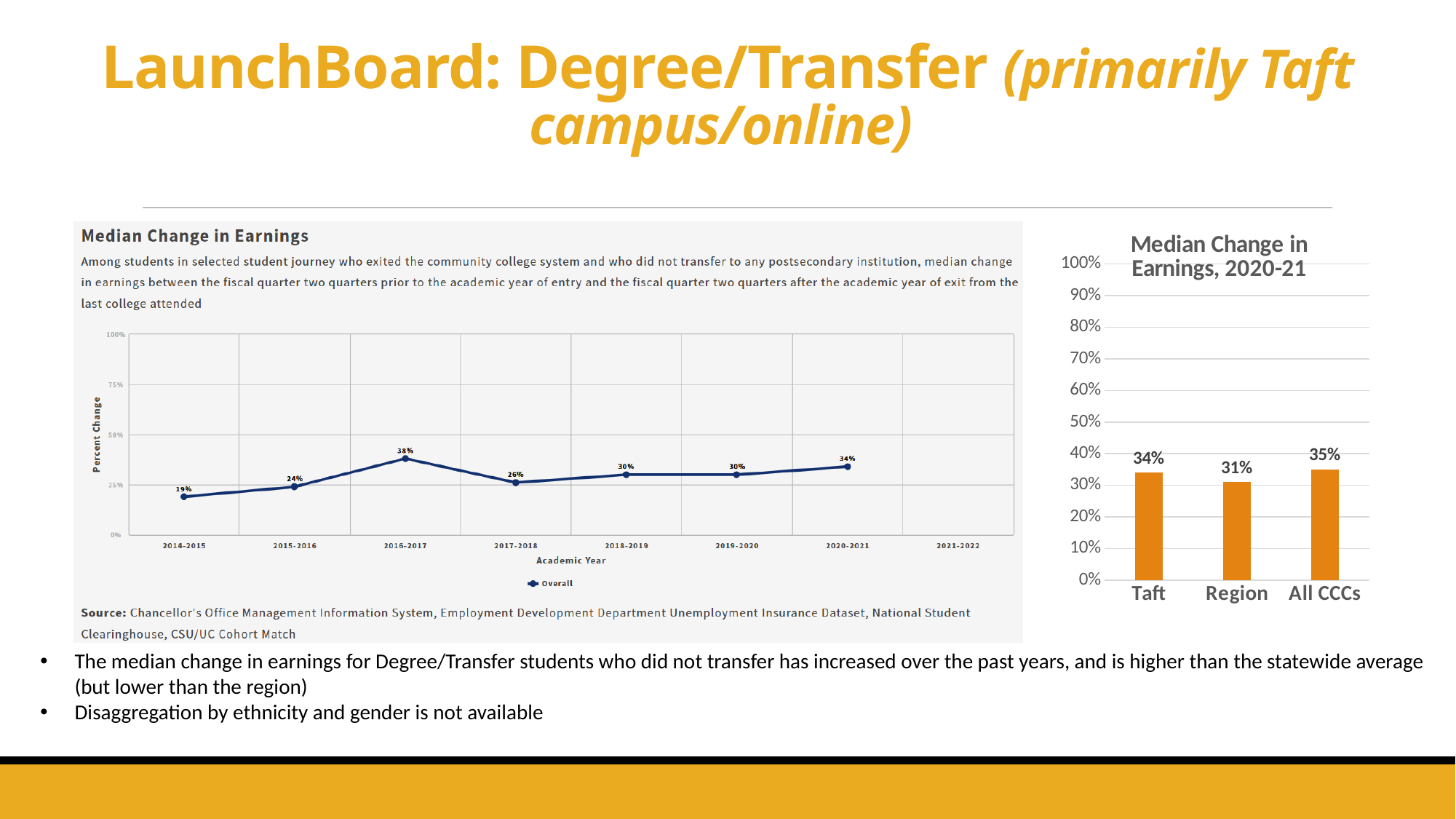
In the 'Median Change in Earnings' line chart on the left, what series name does the legend show? Overall In the 'Median Change in Earnings' line chart on the left, what is the value for 2014-2015? 19% In the 'Median Change in Earnings, 2020-21' bar chart, what is the difference between All CCCs and Region? 4% In the 'Median Change in Earnings, 2020-21' bar chart, what is the value for Taft? 34% What kind of chart is the 'Median Change in Earnings, 2020-21' chart on the right? Bar chart In the 'Median Change in Earnings, 2020-21' bar chart, how many categories are shown? 3 In the 'Median Change in Earnings' line chart on the left, which academic year has the highest value? 2016-2017 In the 'Median Change in Earnings' line chart on the left, what is the value for 2016-2017? 38% In the 'Median Change in Earnings' line chart on the left, what is the difference between 2020-2021 and 2017-2018? 8% In the 'Median Change in Earnings' line chart on the left, which is larger: the value for 2015-2016 or 2019-2020? 2019-2020 In the 'Median Change in Earnings, 2020-21' bar chart, what is the value for Region? 31% In the 'Median Change in Earnings, 2020-21' bar chart, which category has the lowest value? Region